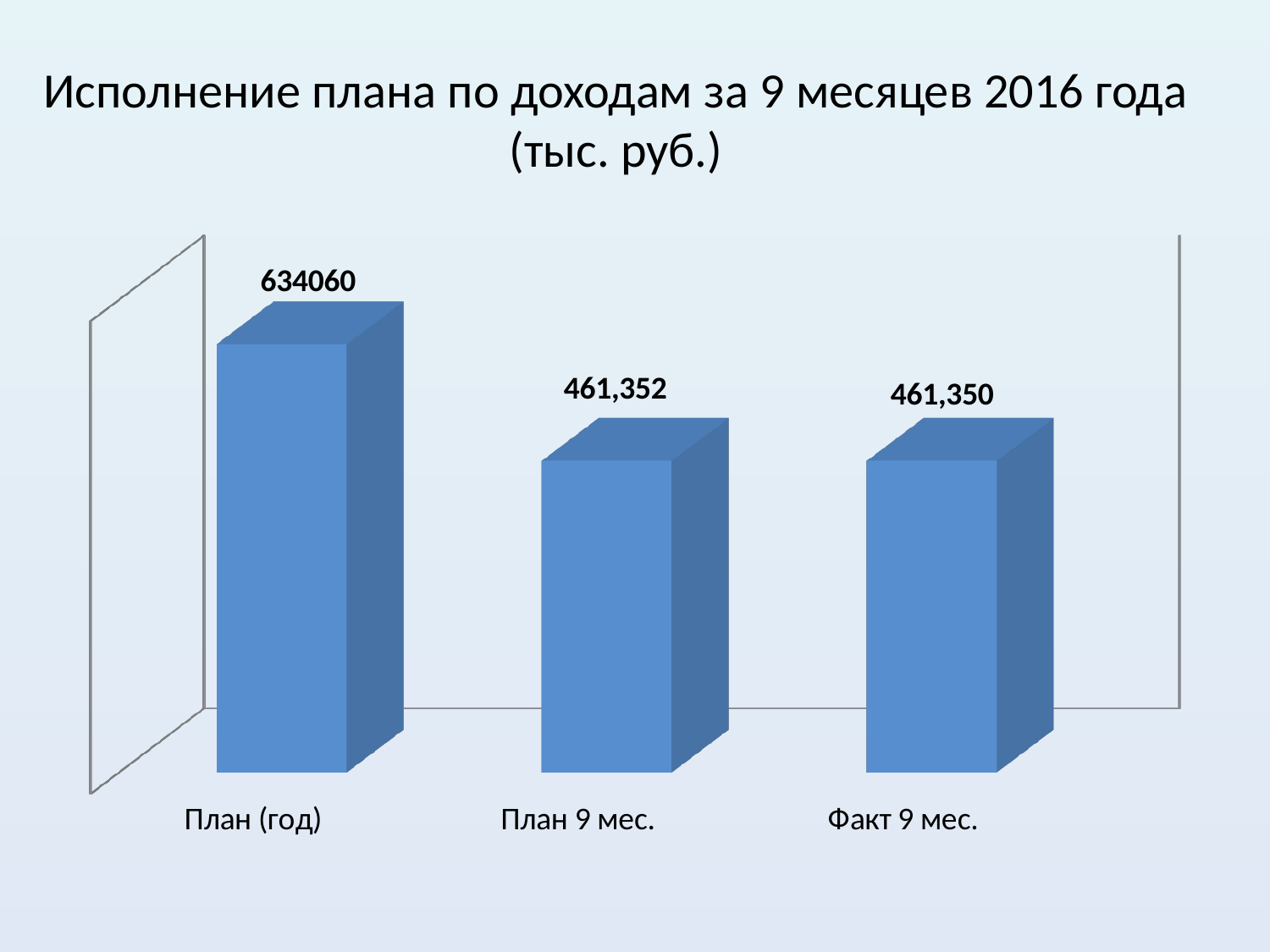
What is the value for План 9 мес.? 461,352 How many categories are shown on the chart? 3 Which category has the highest value? План (год) Is the value for План (год) larger or smaller than the value for План 9 мес.? larger What is the title of the slide? Исполнение плана по доходам за 9 месяцев 2016 года (тыс. руб.) What kind of chart is shown on the slide? bar chart In what units are the values on the chart given, according to the title? тыс. руб. What is the value for План (год)? 634060 What is the difference between the values for План 9 мес. and Факт 9 мес.? 2 What is the value for Факт 9 мес.? 461,350 Do the values rise or fall from left to right along the x axis? fall